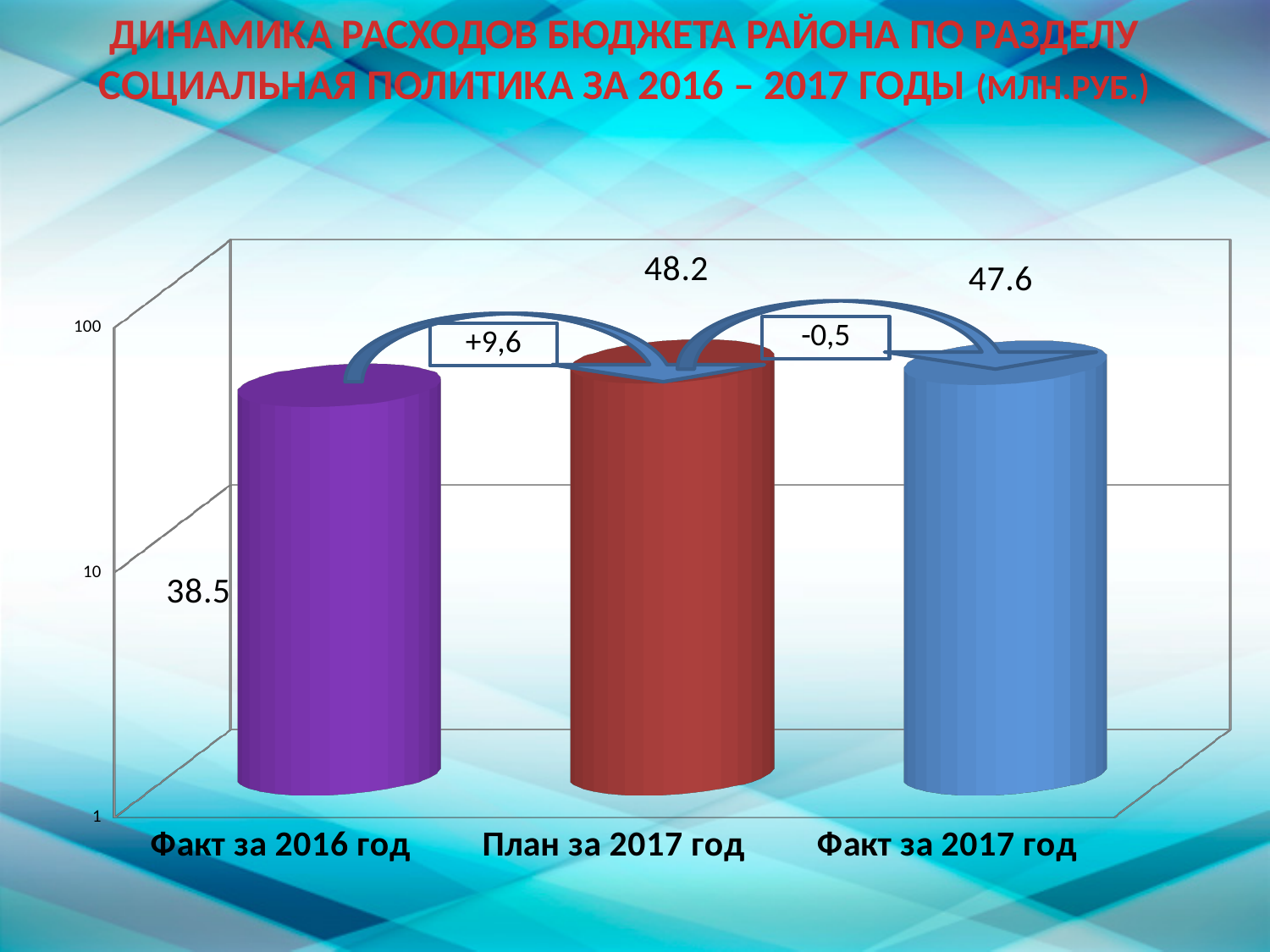
What is the difference between the values for План за 2017 год and Факт за 2017 год? 0.6 Which category has the highest value? План за 2017 год What change is shown in the annotation box between Факт за 2016 год and План за 2017 год? +9,6 How many categories are shown on the chart? 3 What is the value for План за 2017 год? 48.2 Is the value for Факт за 2016 год greater or less than 10? greater What is the difference between the values for План за 2017 год and Факт за 2016 год? 9.7 What is the value for Факт за 2017 год? 47.6 Which category has the lowest value? Факт за 2016 год What is the value for Факт за 2016 год? 38.5 What kind of chart is shown on the slide? bar chart Which is larger, the value for Факт за 2017 год or the value for Факт за 2016 год? Факт за 2017 год